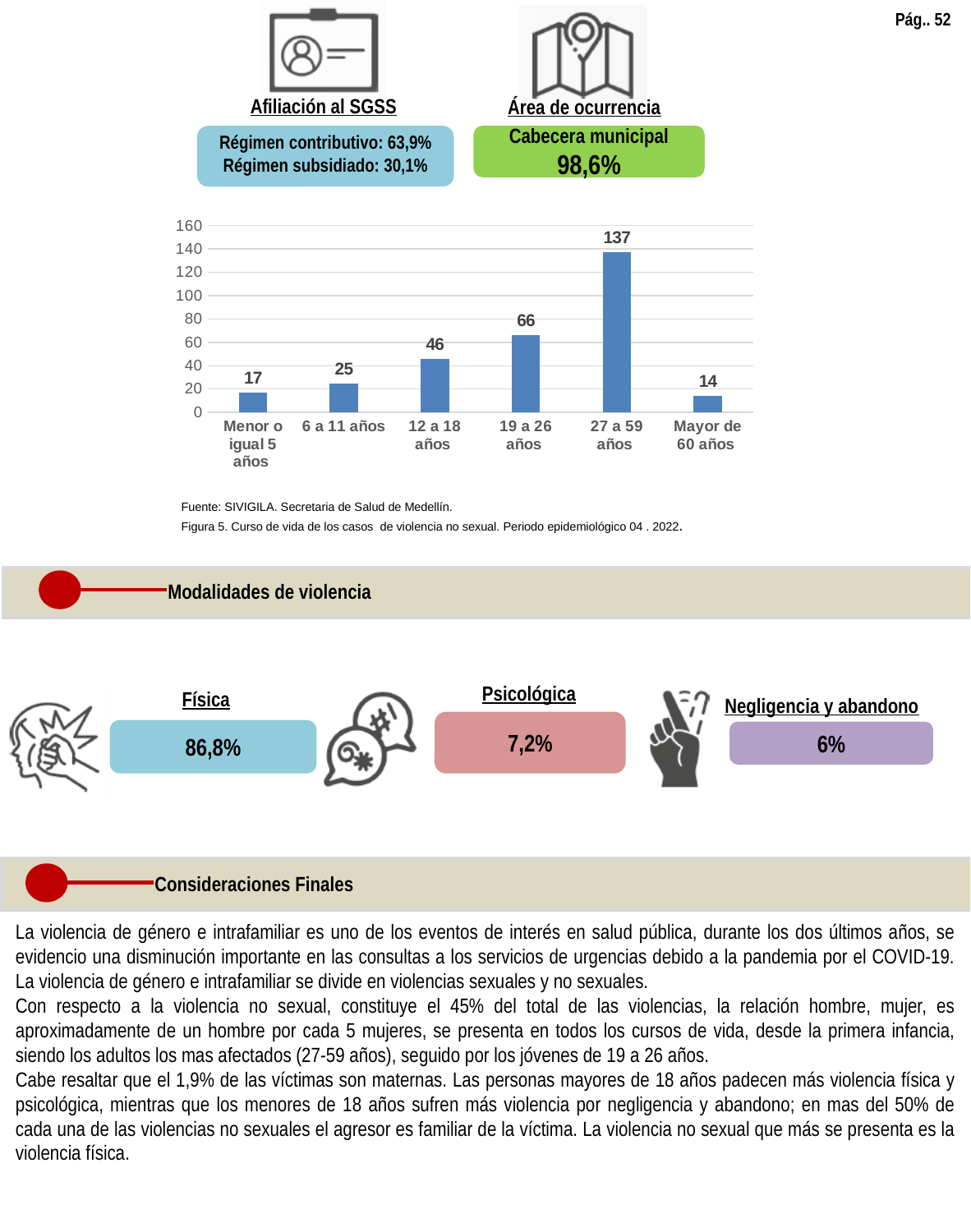
What is the difference between the values for '6 a 11 años' and 'Menor o igual 5 años' in the bar chart? 8 Which age group has the highest value in the bar chart? 27 a 59 años Is the value for '27 a 59 años' in the bar chart greater or less than 120? greater What is the caption (figure title) of the bar chart? Figura 5. Curso de vida de los casos de violencia no sexual. Periodo epidemiológico 04 . 2022 What is the value for the '12 a 18 años' category in the bar chart? 46 Which is larger in the bar chart: the value for '19 a 26 años' or the value for '12 a 18 años'? 19 a 26 años Which age group has the lowest value in the bar chart? Mayor de 60 años What is the difference between the values for '27 a 59 años' and '19 a 26 años' in the bar chart? 71 What is the value for the '27 a 59 años' category in the bar chart? 137 What type of chart is shown on the slide? bar chart What is the value for the 'Menor o igual 5 años' category in the bar chart? 17 How many age-group categories are shown in the bar chart? 6